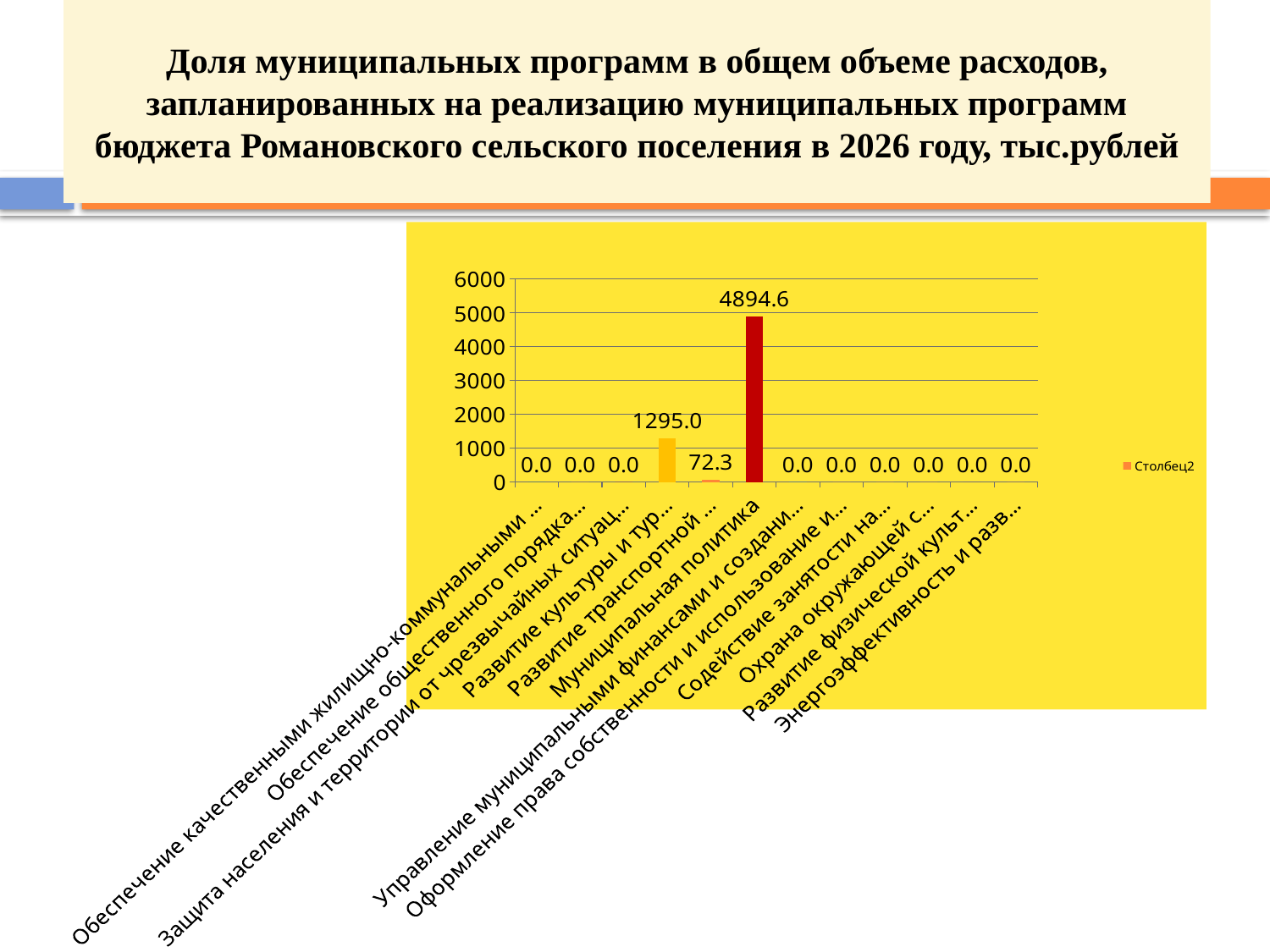
What is the value for the category beginning 'Охрана окружающей'? 0.0 Which category has the highest value? Муниципальная политика How many categories are shown on the x axis? 12 What is the difference between the value for the category beginning 'Развитие культуры' and the value for the category beginning 'Развитие транспортной'? 1222.7 What type of chart is shown on the slide? bar chart What is the difference between the value for 'Муниципальная политика' and the value for the category beginning 'Развитие культуры'? 3599.6 What is the value for the category beginning 'Развитие культуры'? 1295.0 Which is larger: the value for 'Муниципальная политика' or the value for the category beginning 'Развитие культуры'? Муниципальная политика What is the value for the category 'Муниципальная политика'? 4894.6 What is the value for the category beginning 'Развитие транспортной'? 72.3 Is the value for 'Муниципальная политика' greater or less than 4000? greater What is the name of the series listed in the legend? Столбец2